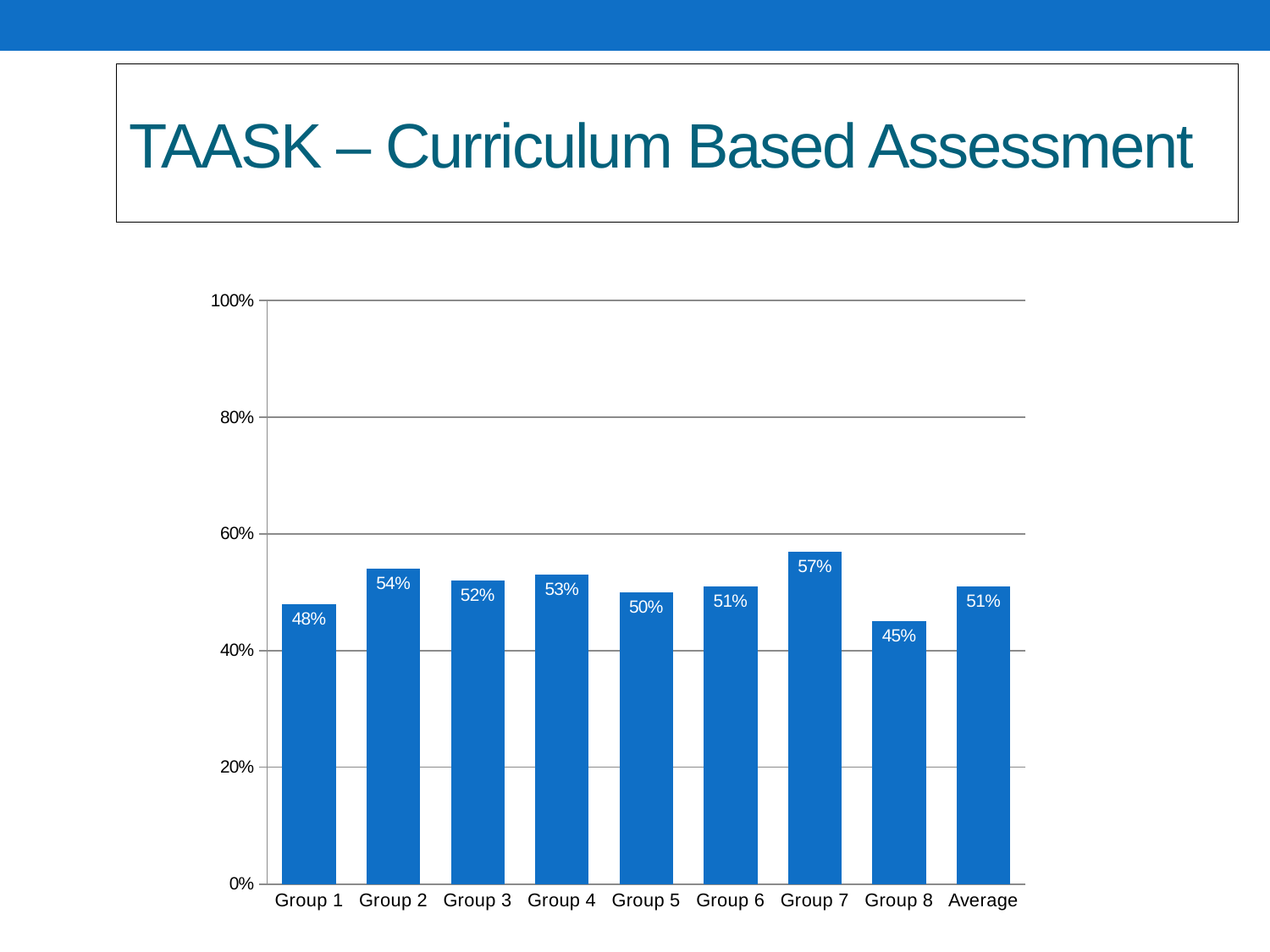
What kind of chart is shown on the slide? bar chart What is the value for Group 7? 57% Which category has the highest value? Group 7 Is the value for Group 7 greater or less than 60%? less Which category has the lowest value? Group 8 What is the difference between the values for Group 2 and Group 1? 6% What is the difference between the values for Group 7 and Group 8? 12% What is the value for Group 1? 48% What is the value for Average? 51% How many categories are shown on the x axis? 9 Which is larger, the value for Group 2 or the value for Group 5? Group 2 What is the title of the slide containing the chart? TAASK – Curriculum Based Assessment